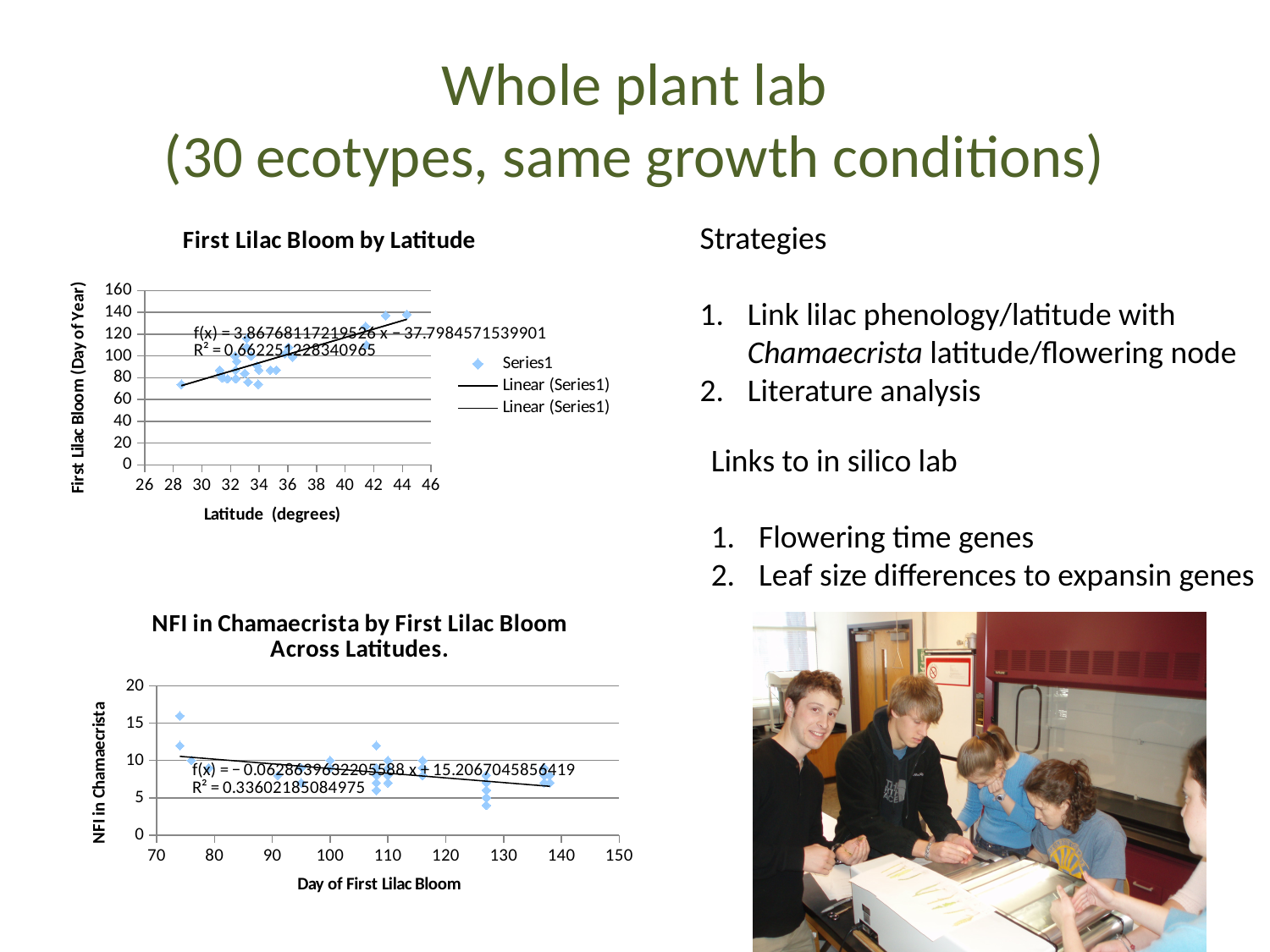
What type of chart is the top-left chart titled 'First Lilac Bloom by Latitude'? Scatter chart What is the y-axis title of the 'NFI in Chamaecrista by First Lilac Bloom Across Latitudes.' chart? NFI in Chamaecrista What R² value is printed on the 'First Lilac Bloom by Latitude' chart? R² = 0.662251228340965 In the 'First Lilac Bloom by Latitude' chart, do the values generally rise or fall as latitude increases? Rise What is the trendline equation shown on the 'First Lilac Bloom by Latitude' chart? f(x) = 3.86768117219526 x − 37.7984571539901 What is the x-axis title of the 'First Lilac Bloom by Latitude' chart? Latitude (degrees) In the 'First Lilac Bloom by Latitude' chart, is the highest plotted point greater or less than 120 days? greater In the 'NFI in Chamaecrista by First Lilac Bloom Across Latitudes.' chart, does the trendline rise or fall as Day of First Lilac Bloom increases? Fall What R² value is printed on the 'NFI in Chamaecrista by First Lilac Bloom Across Latitudes.' chart? R² = 0.33602185084975 In the 'NFI in Chamaecrista by First Lilac Bloom Across Latitudes.' chart, is the highest plotted point greater or less than 10? greater What type of chart is the bottom-left chart titled 'NFI in Chamaecrista by First Lilac Bloom Across Latitudes.'? Scatter chart How many entries does the legend of the 'First Lilac Bloom by Latitude' chart list? 3